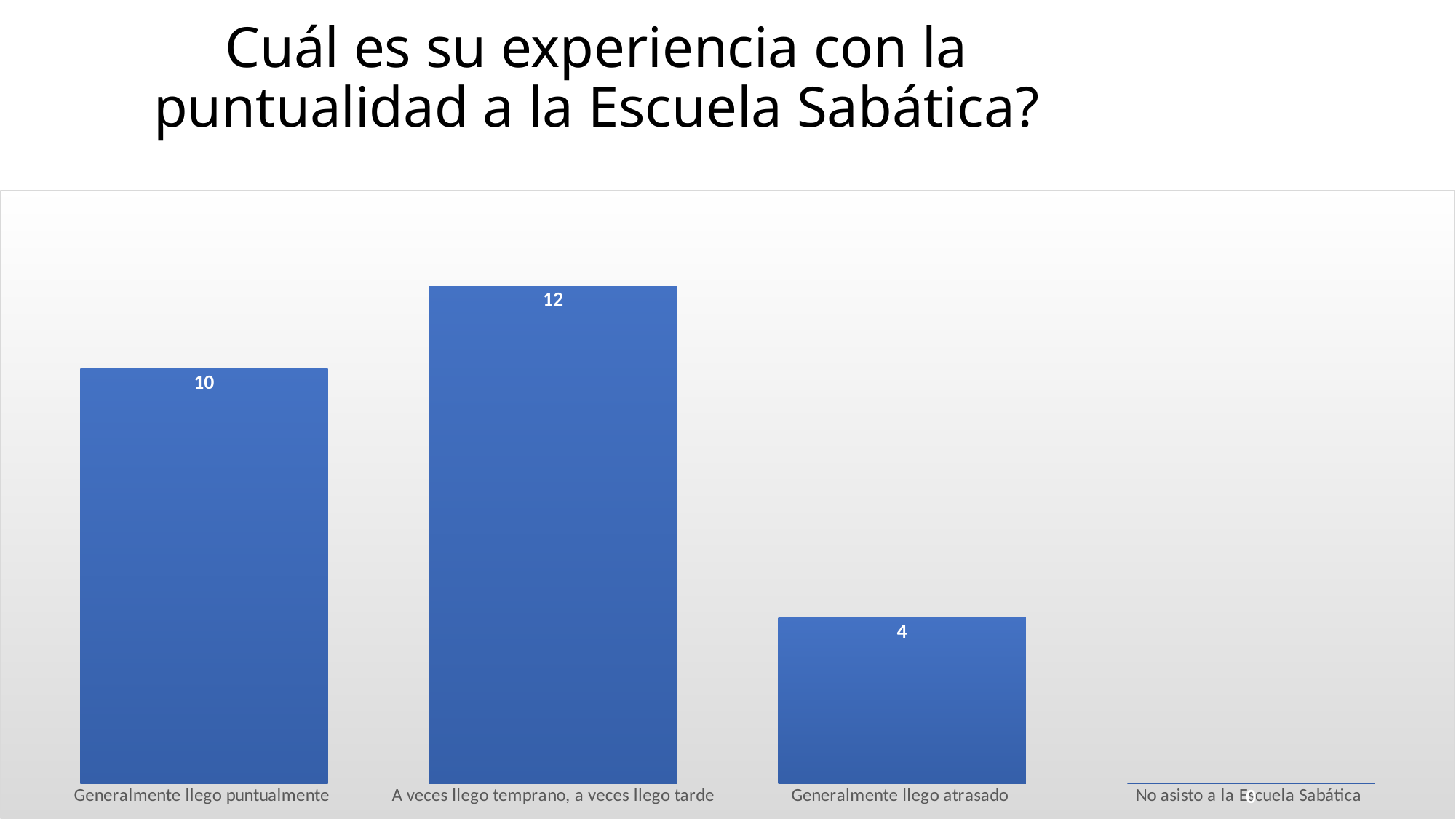
What is the value for "Generalmente llego puntualmente"? 10 How many categories are shown in the chart? 4 What is the value for "A veces llego temprano, a veces llego tarde"? 12 What is the difference between the values for "Generalmente llego puntualmente" and "Generalmente llego atrasado"? 6 Which is larger, the value for "Generalmente llego puntualmente" or the value for "Generalmente llego atrasado"? Generalmente llego puntualmente What is the difference between the values for "A veces llego temprano, a veces llego tarde" and "Generalmente llego puntualmente"? 2 What is the value for "Generalmente llego atrasado"? 4 What colour are the bars in the chart? Blue What kind of chart is shown on the slide? Bar chart Which category has the highest value? A veces llego temprano, a veces llego tarde What is the title of the slide? Cuál es su experiencia con la puntualidad a la Escuela Sabática? Which category has the lowest value? No asisto a la Escuela Sabática